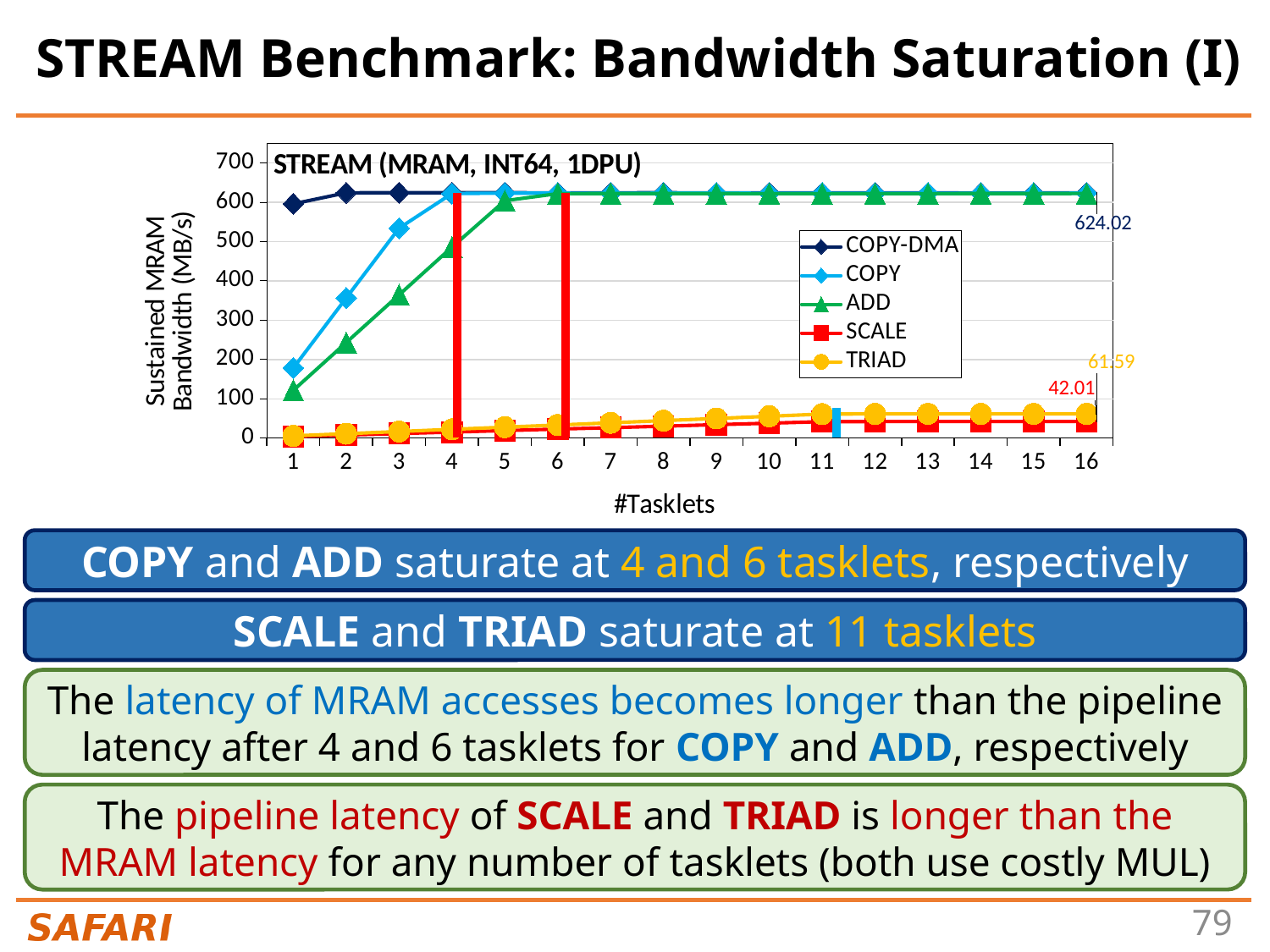
What is the sustained MRAM bandwidth of TRIAD at 16 tasklets? 61.59 What is the sustained MRAM bandwidth of COPY-DMA at 16 tasklets? 624.02 Is the value for COPY at 1 tasklet greater or less than 200? less At 16 tasklets, how much higher is TRIAD's bandwidth than SCALE's? 19.58 At 16 tasklets, which has the higher bandwidth, SCALE or TRIAD? TRIAD How many tasklet counts are plotted along the x axis? 16 What is the title shown inside the chart area? STREAM (MRAM, INT64, 1DPU) Does the ADD series rise or fall from 1 to 6 tasklets? rises How many series does the chart legend list? 5 What kind of chart is shown on the slide? line chart What is the sustained MRAM bandwidth of SCALE at 16 tasklets? 42.01 Is the value for COPY-DMA at 1 tasklet greater or less than 500? greater